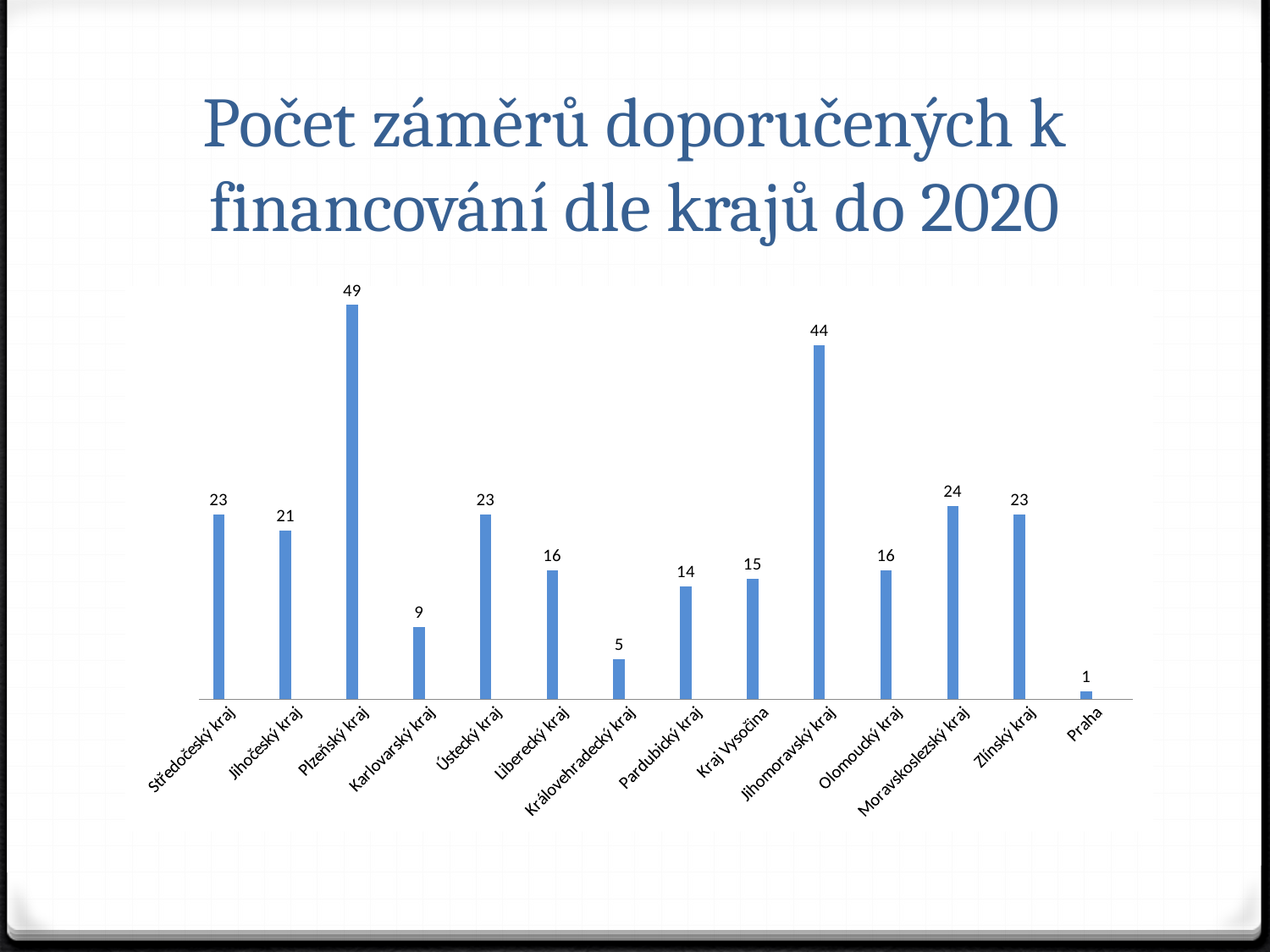
Which is larger, the value for Jihočeský kraj or the value for Liberecký kraj? Jihočeský kraj Which region has the highest value? Plzeňský kraj Which region has the lowest value? Praha What is the difference between the values for Moravskoslezský kraj and Královehradecký kraj? 19 How many regions are shown on the chart? 14 What is the value for Karlovarský kraj? 9 What is the value for Praha? 1 What kind of chart is shown on the slide? Bar chart What is the value for Plzeňský kraj? 49 What is the title of the slide? Počet záměrů doporučených k financování dle krajů do 2020 What is the value for Jihomoravský kraj? 44 What is the difference between the values for Plzeňský kraj and Jihomoravský kraj? 5